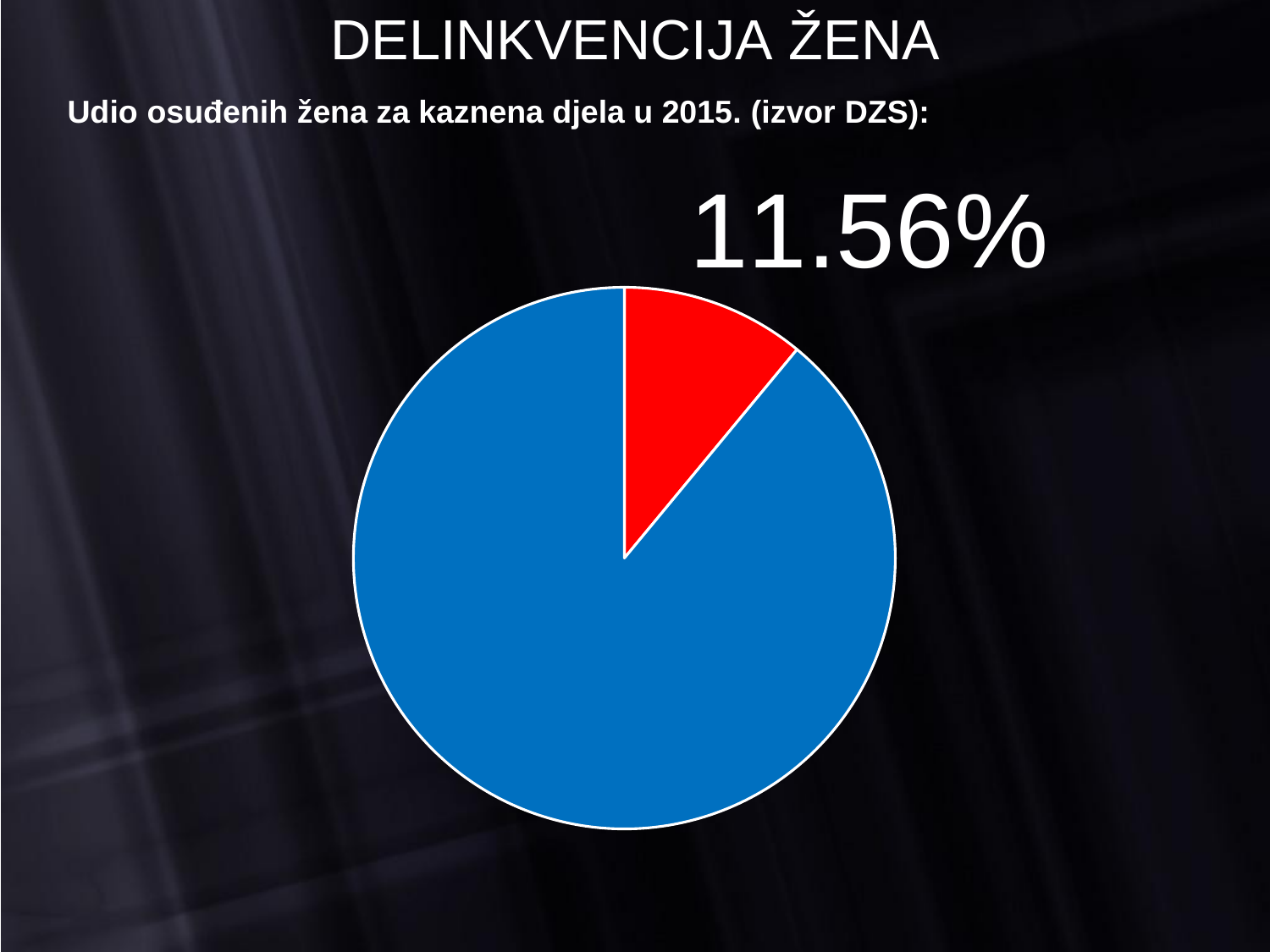
What percentage value is printed as a data label on the pie chart? 11.56% Which slice of the pie chart is the smallest? the red slice What colour is the slice labelled 11.56%? red Which slice of the pie chart is the largest? the blue slice What kind of chart is shown on the slide? pie chart What share of the pie does the blue slice represent, given the red slice is 11.56%? 88.44% What is the caption above the pie chart describing what it shows? Udio osuđenih žena za kaznena djela u 2015. (izvor DZS): What share of the pie does the red slice represent? 11.56% How many slices does the pie chart have? 2 Which slice of the pie chart is larger, the red one or the blue one? blue